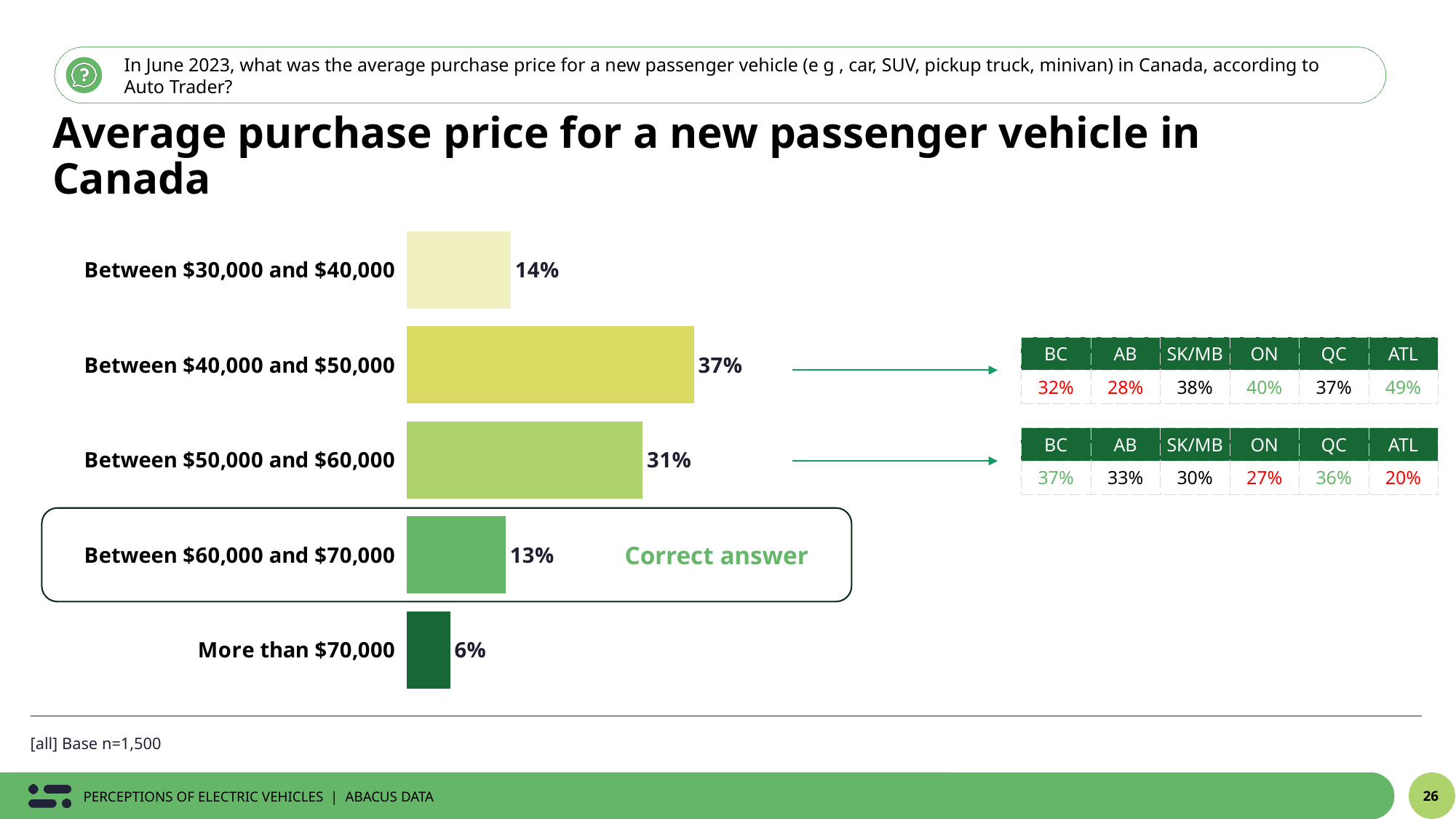
Which price range received the lowest share of responses? More than $70,000 How many price-range categories are shown in the bar chart? 5 In the regional breakdown for 'Between $50,000 and $60,000', what is the value for ON? 27% What type of chart is used to show the price-range responses? Bar chart What percentage of respondents answered 'Between $40,000 and $50,000'? 37% Which price range received the highest share of responses? Between $40,000 and $50,000 In the regional breakdown for 'Between $40,000 and $50,000', what is the value for ATL? 49% What percentage of respondents answered 'More than $70,000'? 6% Which price range is marked as the correct answer on the slide? Between $60,000 and $70,000 What is the difference in percentage points between 'Between $40,000 and $50,000' and 'Between $50,000 and $60,000'? 6 What percentage of respondents chose 'Between $60,000 and $70,000', the correct answer? 13% Which has a larger share: 'Between $30,000 and $40,000' or 'Between $60,000 and $70,000'? Between $30,000 and $40,000